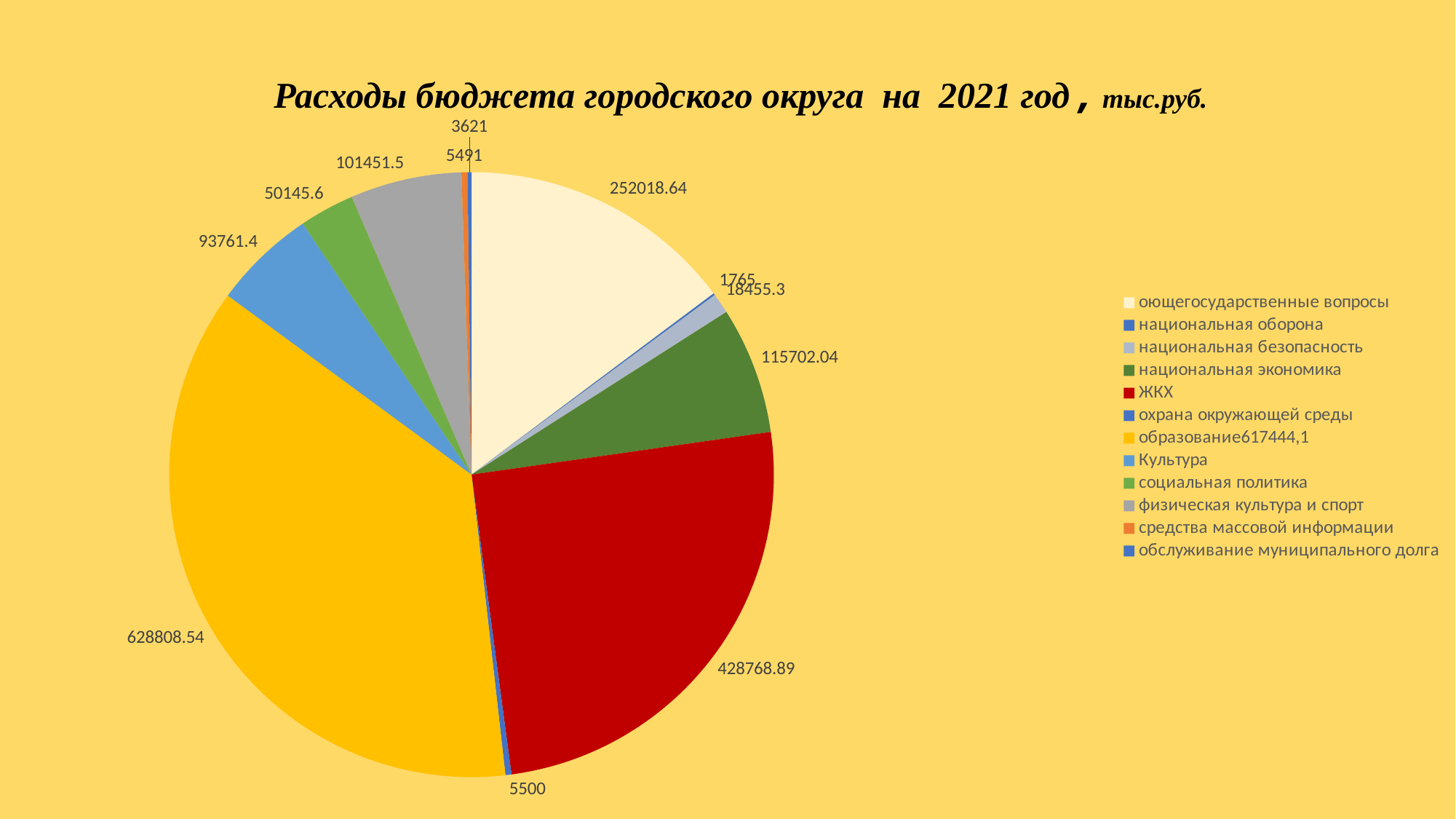
Which category has the smallest value? национальная оборона Which category has the largest slice of the pie? образование How many categories does the legend of the pie chart list? 12 What is the value for физическая культура и спорт? 101451.5 What kind of chart is shown on the slide? pie chart What is the difference between the values for образование (628808.54) and ЖКХ (428768.89)? 200039.65 Which is larger, ЖКХ or образование? образование What is the value for национальная экономика? 115702.04 What is the title of the chart? Расходы бюджета городского округа на 2021 год, тыс.руб. What is the value for Культура? 93761.4 What is the value for средства массовой информации? 5491 What is the value for ЖКХ? 428768.89